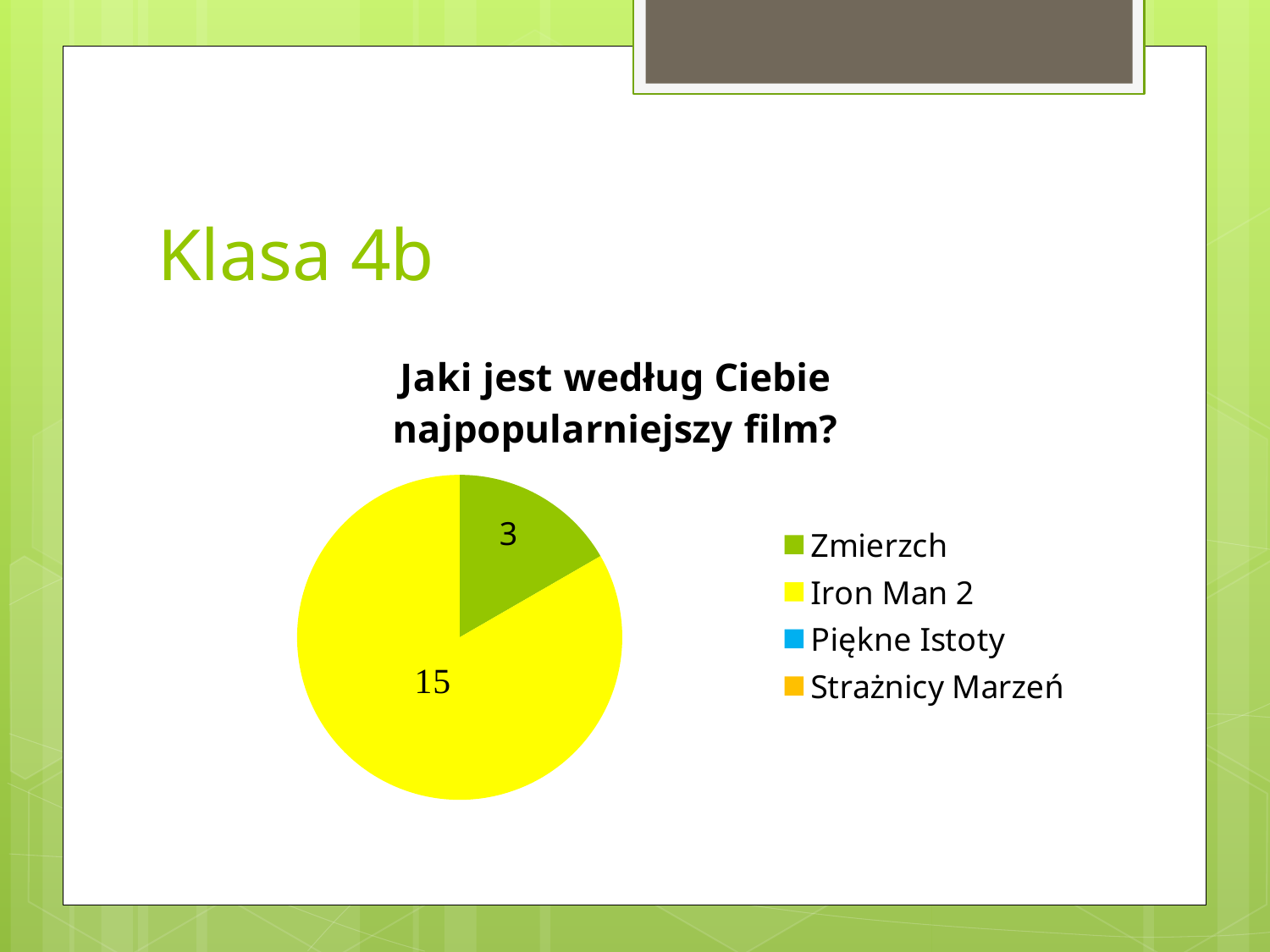
How many entries does the legend of the pie chart list? 4 What is the total of the two labelled slices in the pie chart? 18 Which of the two labelled slices is smaller, Zmierzch or Iron Man 2? Zmierzch How many slices in the pie chart have a data label? 2 What is the value shown for Zmierzch in the pie chart? 3 What is the difference between the values for Iron Man 2 and Zmierzch? 12 Which film has the largest slice in the pie chart? Iron Man 2 Which legend entry is shown in yellow? Iron Man 2 Which value is larger, Zmierzch or Iron Man 2? Iron Man 2 What is the value shown for Iron Man 2 in the pie chart? 15 What type of chart is shown on the slide? pie chart What is the title of the pie chart? Jaki jest według Ciebie najpopularniejszy film?